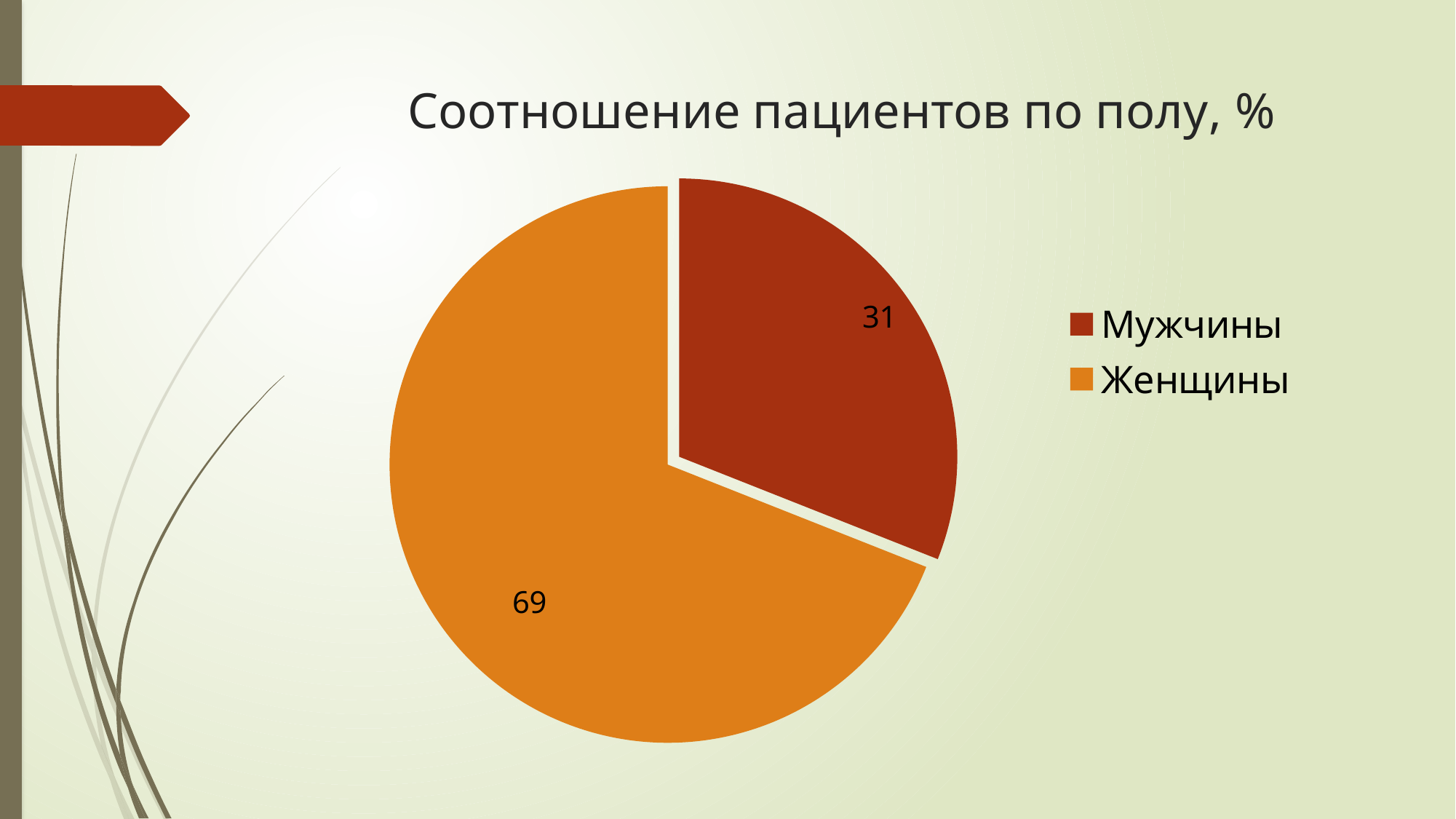
Which category has the largest slice? Женщины What is the total of the two slice values? 100 Which is larger, the value for Мужчины or the value for Женщины? Женщины Which colour represents Мужчины in the chart? dark red Which category has the smallest slice? Мужчины What is the value for Мужчины? 31 What is the value for Женщины? 69 How many slices does the pie chart have? 2 How many entries does the legend list? 2 What kind of chart is shown on the slide? pie chart What is the title of the chart? Соотношение пациентов по полу, % What is the difference between the values for Женщины and Мужчины? 38